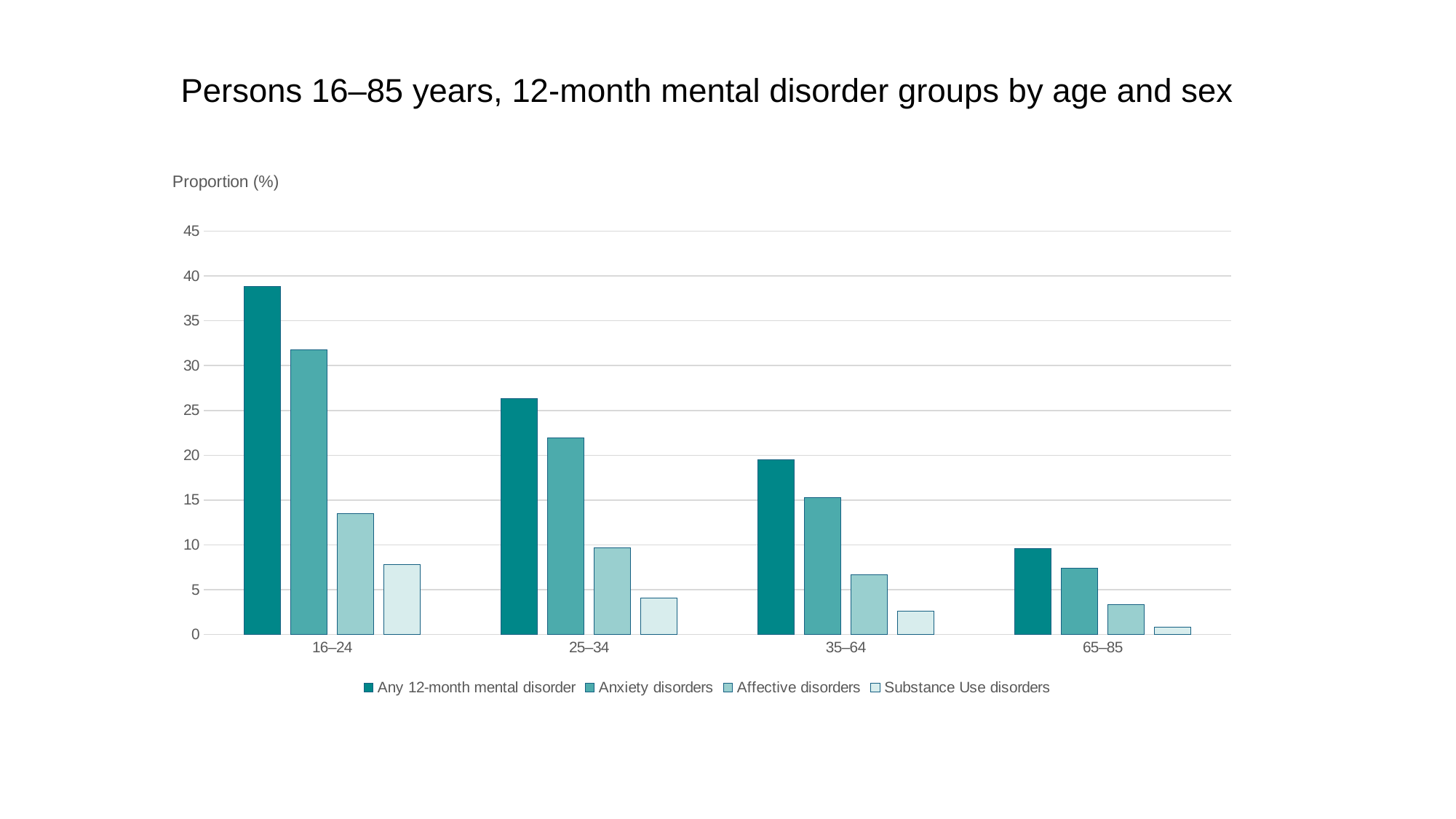
How many age groups are shown on the x axis? 4 Which age group has the lowest value for Substance Use disorders? 65–85 What is the label on the y axis? Proportion (%) Is the value for Any 12-month mental disorder in the 16–24 age group greater or less than 35? greater Which age group has the highest value for Any 12-month mental disorder? 16–24 Is the value for Substance Use disorders in the 25–34 age group greater or less than 5? less Is the value for Anxiety disorders in the 16–24 age group greater or less than 30? greater What kind of chart is shown on the slide? bar chart How many series does the legend list? 4 Which is larger: Anxiety disorders for 25–34 or Anxiety disorders for 35–64? Anxiety disorders for 25–34 Do the values for Any 12-month mental disorder rise or fall as age increases along the x axis? fall